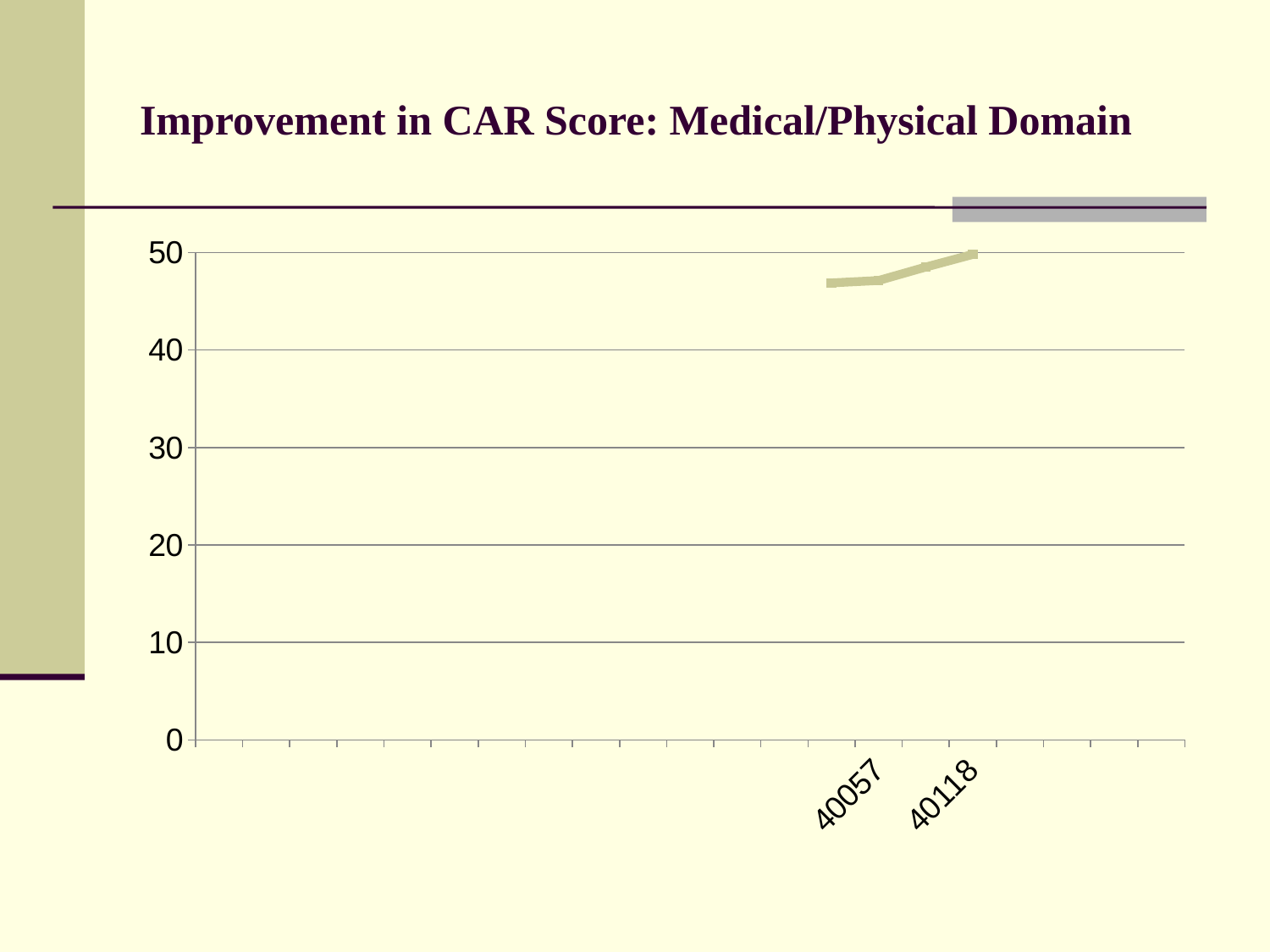
Which x-axis category has the higher value, 40057 or 40118? 40118 What is the highest value shown on the y axis? 50 Which x-axis category has the highest value? 40118 Which x-axis category has the lowest value? 40057 What kind of chart is shown on the slide? line chart Is the value for 40118 greater or less than 40? greater Is the value for 40057 greater or less than 50? less What is the title of the chart? Improvement in CAR Score: Medical/Physical Domain Is the value for 40057 greater or less than 40? greater How many labelled points are plotted on the x axis? 2 Do the values rise or fall from 40057 to 40118? rise